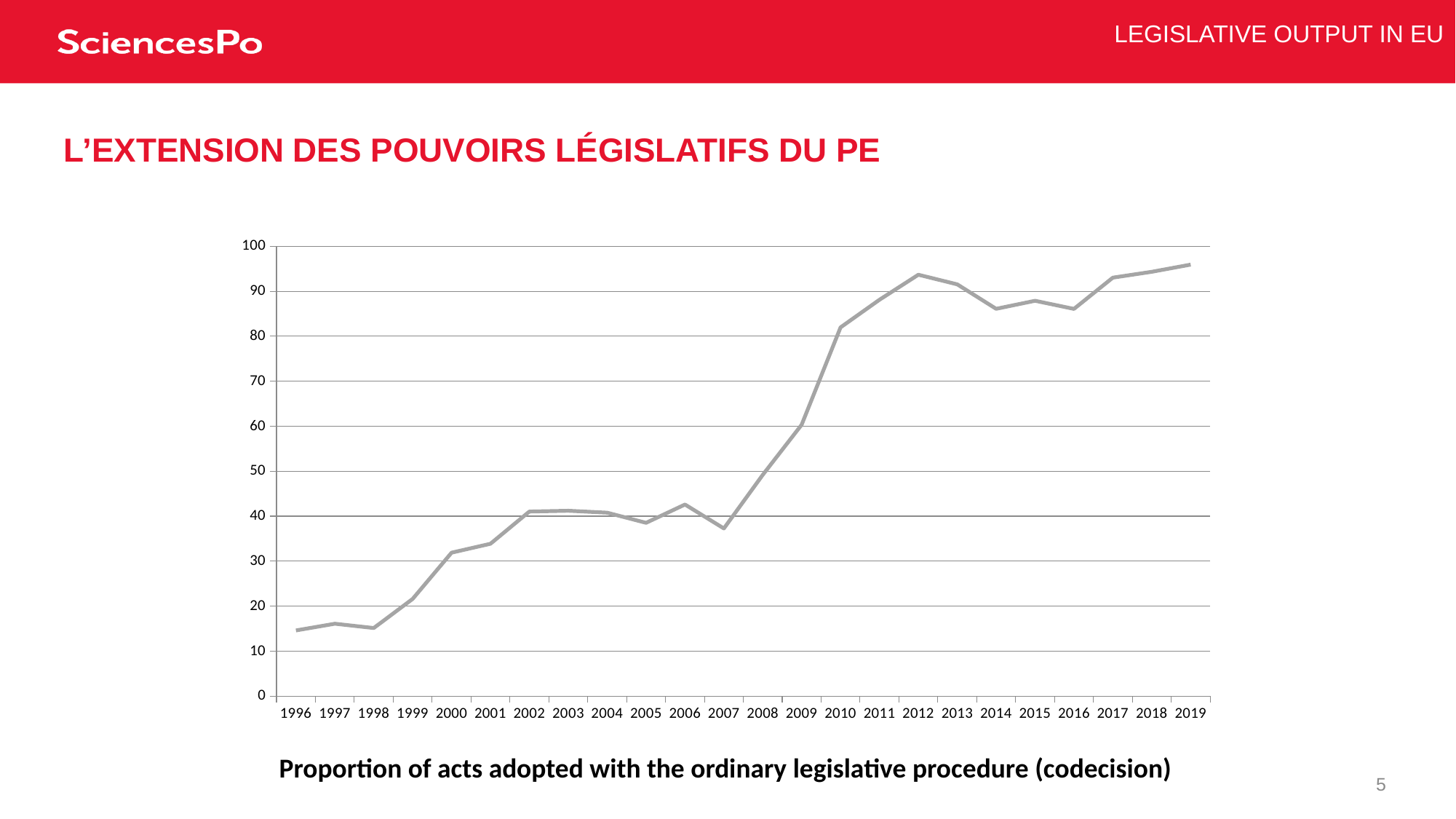
Is the value for 2010 greater or less than 80? greater Is the value for 1996 greater or less than 20? less Is the value for 2007 greater or less than 40? less Overall, do the values rise or fall from 1996 to 2019? rise Which year has the larger value, 2006 or 2007? 2006 What caption is printed below the chart? Proportion of acts adopted with the ordinary legislative procedure (codecision) How many years are plotted along the x axis of the chart? 24 Which year has the larger value, 2009 or 2010? 2010 What kind of chart is shown on the slide? line chart